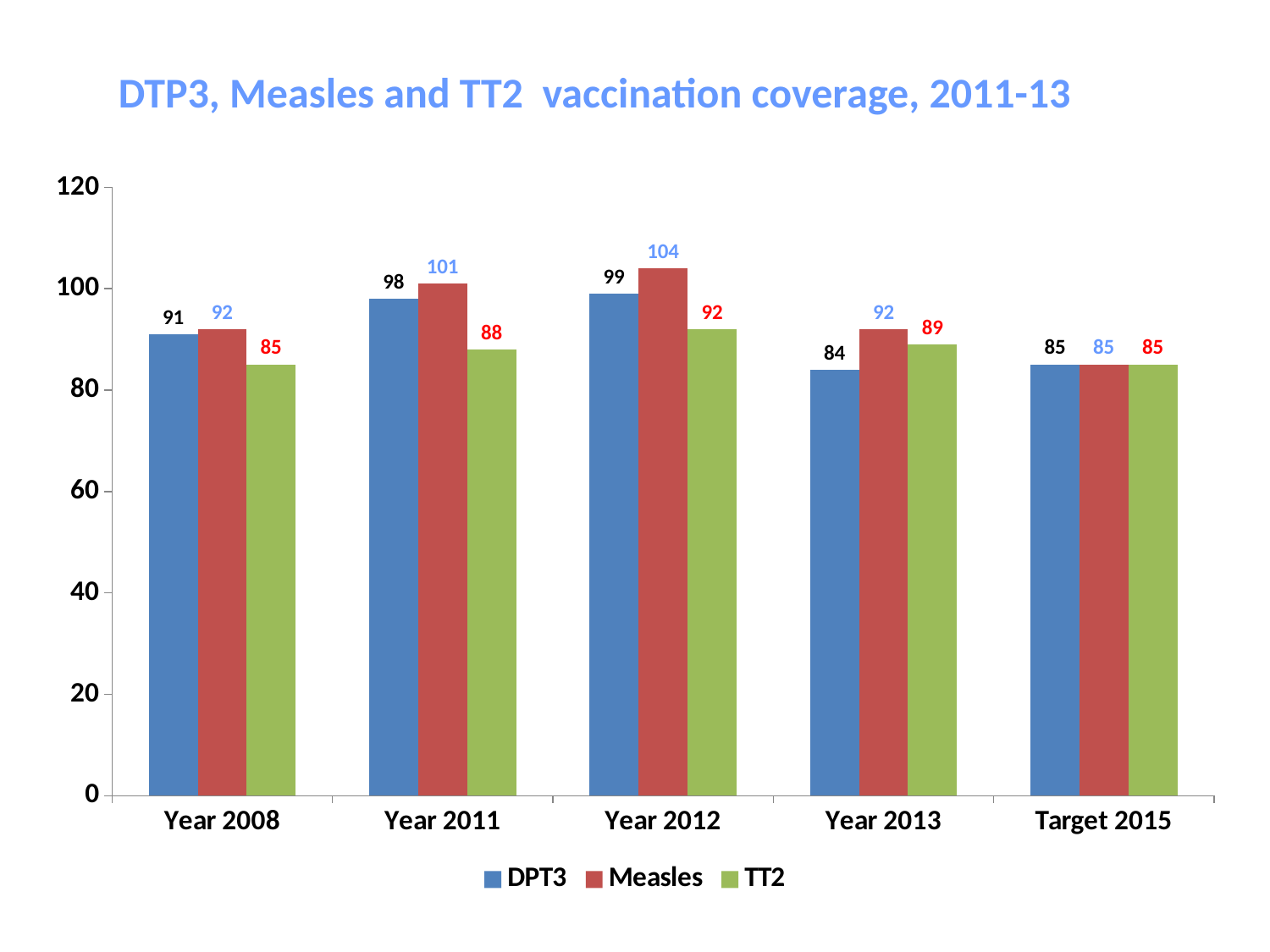
How many series does the legend list? 3 What kind of chart is shown on the slide? bar chart How many categories are shown on the x axis? 5 What is the difference between the Measles value and the TT2 value for Year 2012? 12 What is the title of the chart? DTP3, Measles and TT2 vaccination coverage, 2011-13 What is the Measles value for Year 2011? 101 Which category has the highest Measles value? Year 2012 Is the Measles value for Year 2012 greater or less than 100? greater What is the TT2 value for Year 2013? 89 Which category has the lowest DPT3 value? Year 2013 Which is larger, the DPT3 value for Year 2008 or the DPT3 value for Year 2013? Year 2008 What is the DPT3 value for Year 2012? 99